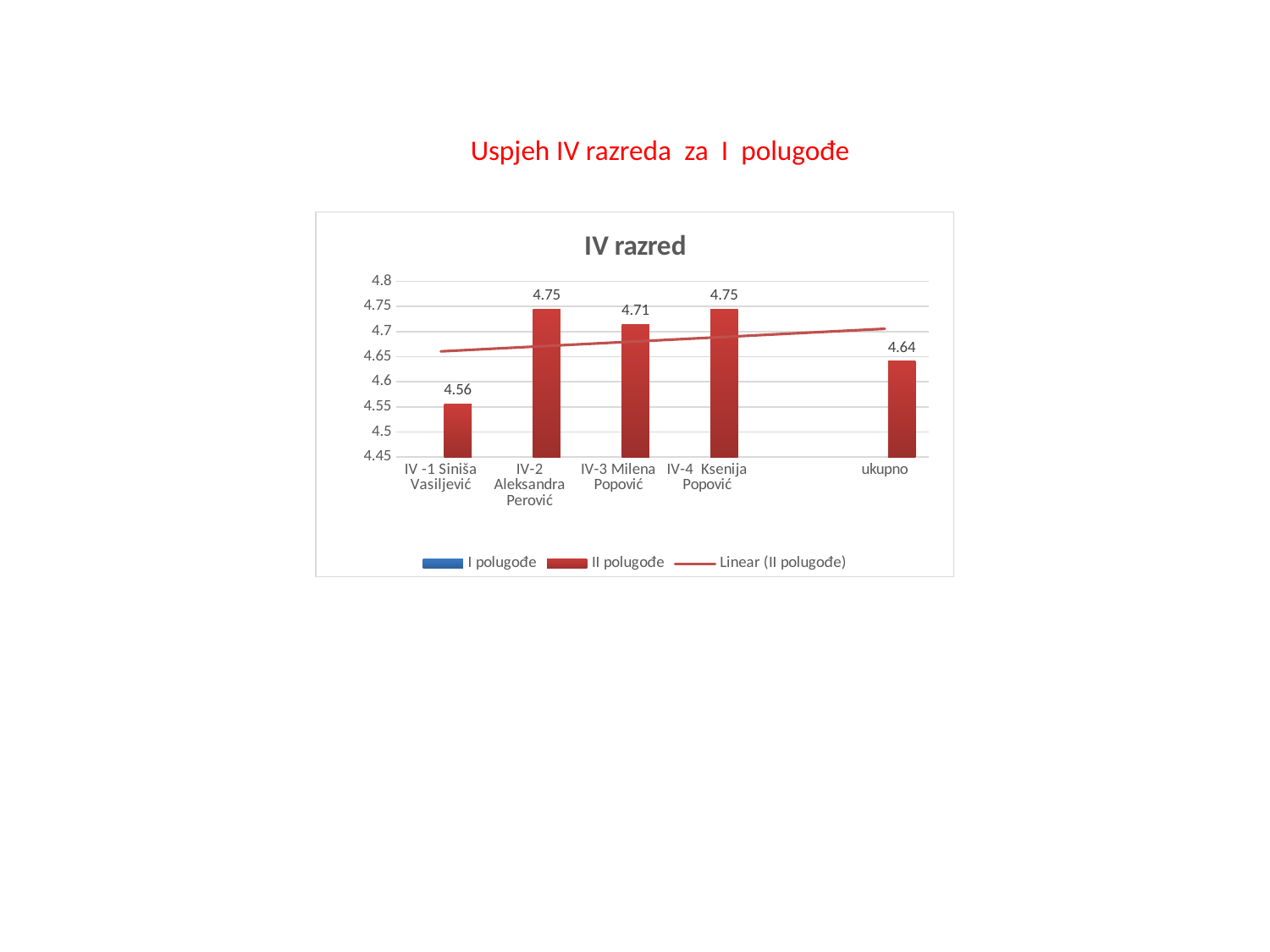
What is the value for IV -1 Siniša Vasiljević? 4.56 What is the difference between the values for IV-2 Aleksandra Perović and IV -1 Siniša Vasiljević? 0.19 What is the difference between the values for IV-3 Milena Popović and ukupno? 0.07 What is the value for ukupno? 4.64 Which is larger, the value for IV-4 Ksenija Popović or the value for ukupno? IV-4 Ksenija Popović How many categories are shown on the x axis? 5 How many entries does the legend list? 3 Is the value for IV -1 Siniša Vasiljević greater or less than 4.6? less What is the value for IV-3 Milena Popović? 4.71 What kind of chart is shown? bar chart What is the value for IV-2 Aleksandra Perović? 4.75 Which category has the lowest value? IV -1 Siniša Vasiljević